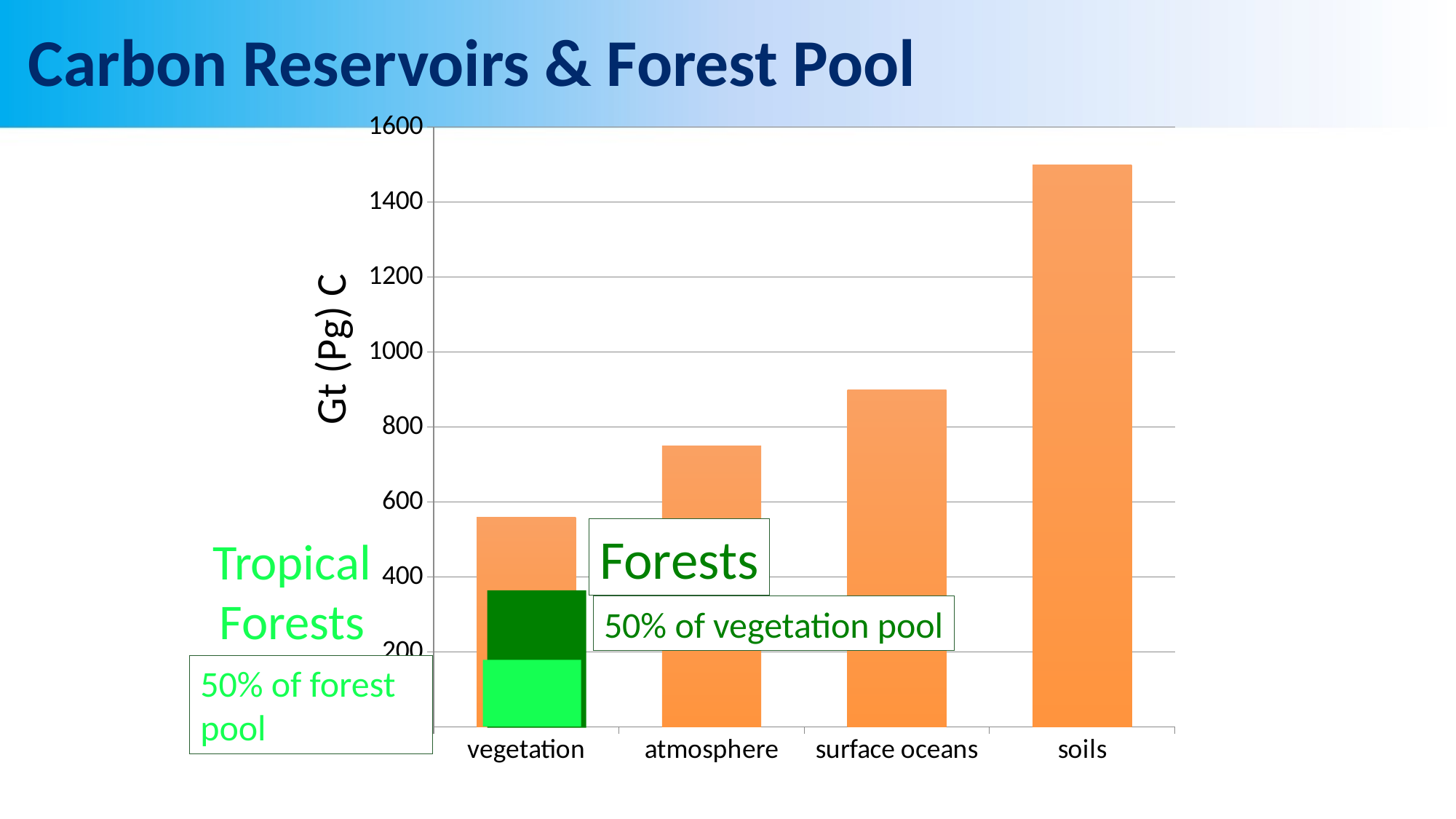
Is the value for soils greater or less than 1400? greater Which category has the lowest value in the chart? vegetation Do the bar values rise or fall from left to right along the x axis? rise What is the title of the slide containing the chart? Carbon Reservoirs & Forest Pool What kind of chart is shown on the slide? bar chart Is the value for atmosphere greater or less than 600? greater What is the label on the y axis of the chart? Gt (Pg) C Which is larger, the value for atmosphere or the value for surface oceans? surface oceans How many categories are shown on the x axis of the chart? 4 Is the value for vegetation greater or less than 600? less Which category has the highest value in the chart? soils